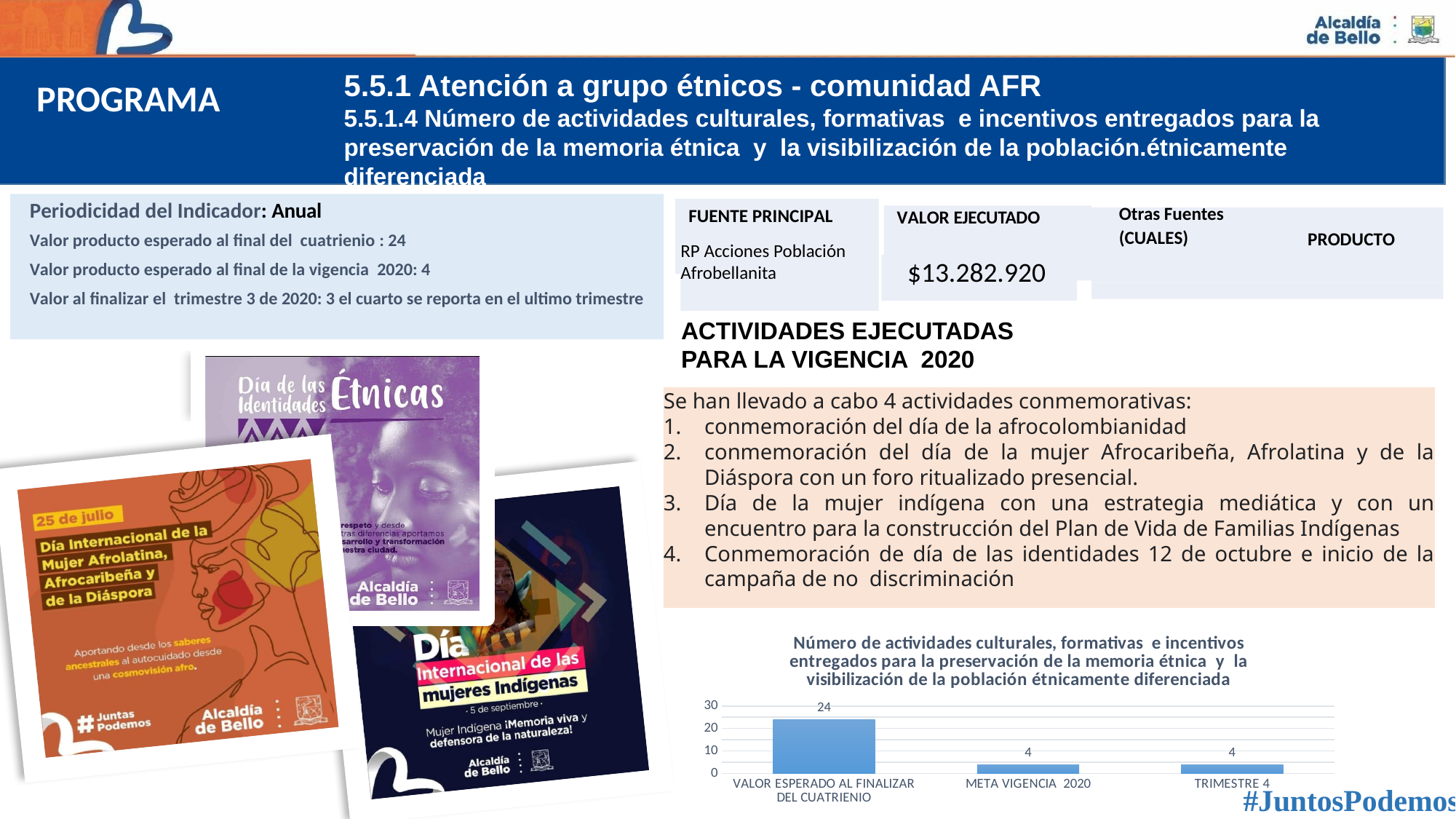
What is the value for VALOR ESPERADO AL FINALIZAR DEL CUATRIENIO in the chart? 24 Is the value for VALOR ESPERADO AL FINALIZAR DEL CUATRIENIO greater or less than 20? greater What is the difference between the value for VALOR ESPERADO AL FINALIZAR DEL CUATRIENIO and the value for META VIGENCIA 2020? 20 How many categories are shown in the chart? 3 What is the highest value shown on the chart's vertical axis? 30 What is the value for META VIGENCIA 2020 in the chart? 4 Do the values for META VIGENCIA 2020 and TRIMESTRE 4 differ? No, both are 4 Is the value for META VIGENCIA 2020 greater or less than 10? less Which is larger, the value for VALOR ESPERADO AL FINALIZAR DEL CUATRIENIO or the value for TRIMESTRE 4? VALOR ESPERADO AL FINALIZAR DEL CUATRIENIO What kind of chart is shown on the slide? Bar chart What is the value for TRIMESTRE 4 in the chart? 4 Which category has the highest value in the chart? VALOR ESPERADO AL FINALIZAR DEL CUATRIENIO